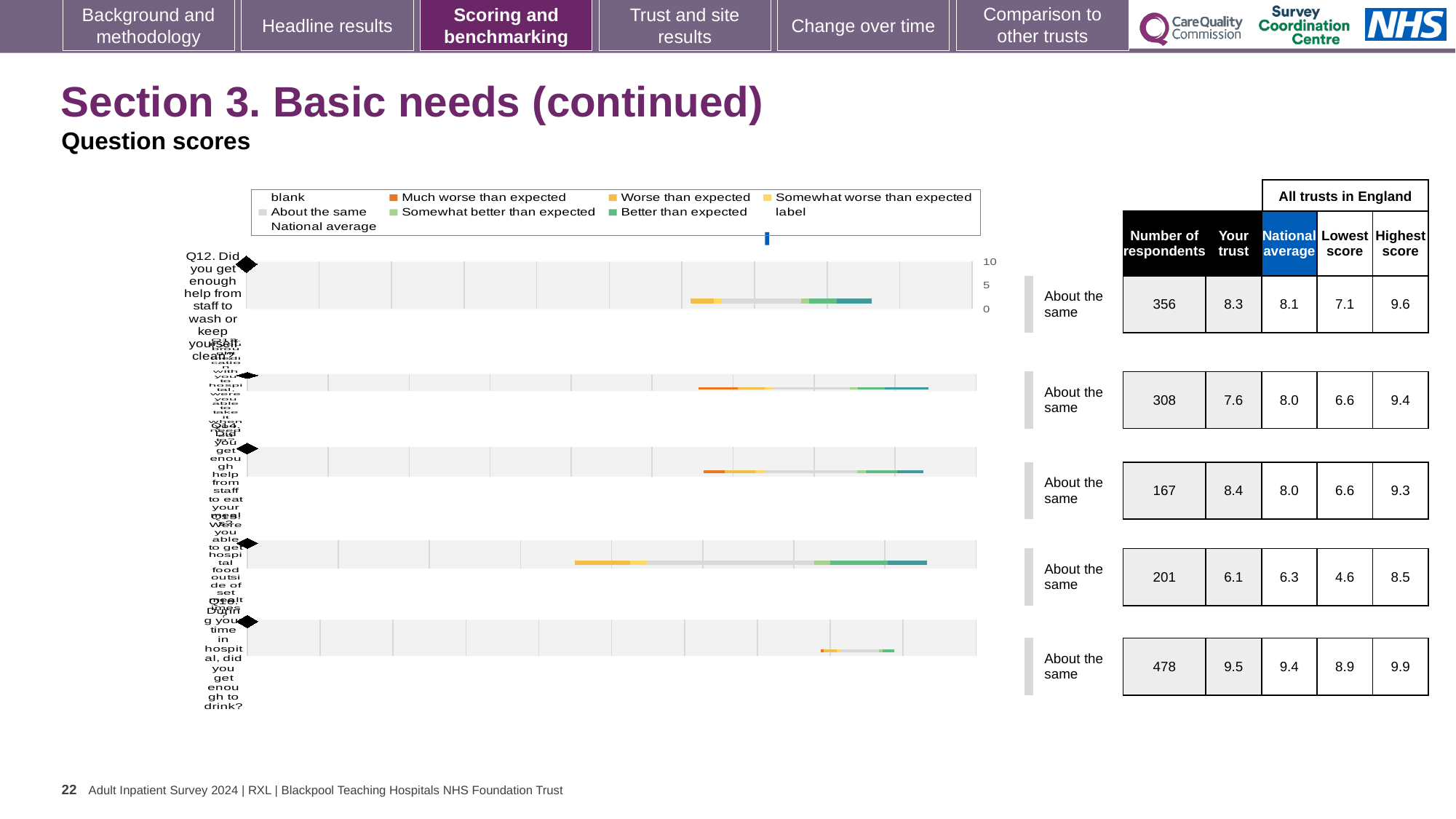
For Q12, what is the difference between the highest score (9.6) and the lowest score (7.1) across all trusts in England? 2.5 What is the national average score for Q12 (help from staff to wash or keep yourself clean)? 8.1 For Q12, which is larger: the 'Your trust' score or the national average? Your trust What is the highest 'Your trust' score shown among the five questions? 9.5 What is the subtitle given to the chart on this slide? Question scores What is the 'Your trust' score for Q12 (help from staff to wash or keep yourself clean)? 8.3 What kind of chart is used to show the question scores on this slide? bar chart What is the number of respondents for the bottom question row (getting enough to drink)? 478 How many respondents answered Q12 (help from staff to wash or keep yourself clean)? 356 What is the lowest 'Your trust' score shown among the five questions? 6.1 What benchmark category is shown for all five questions on this slide? About the same How many question rows (bars) are plotted in the chart? 5